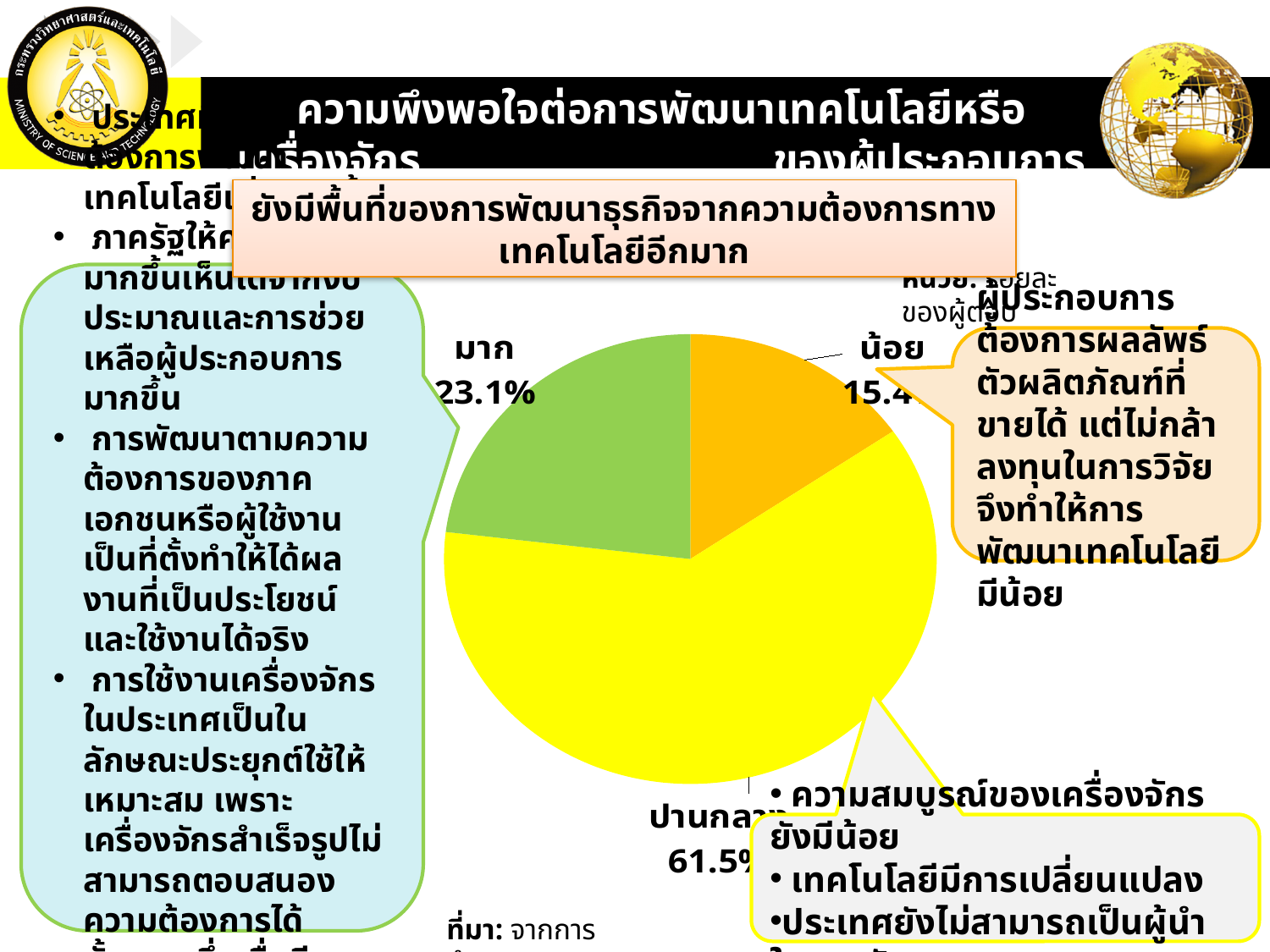
What colour is the ปานกลาง slice of the pie chart? yellow Is the share for ปานกลาง greater or less than 50%? greater How many slices does the pie chart have? 3 What percentage is shown for the ปานกลาง slice? 61.5% What type of chart is shown on the slide? pie chart Which category has the largest share of the pie? ปานกลาง Which slice is larger, มาก or น้อย? มาก What colour is the มาก slice of the pie chart? green What is the difference in percentage points between the ปานกลาง slice and the มาก slice? 38.4% Which category has the smallest share of the pie? น้อย What share of the pie does the มาก slice represent? 23.1% What percentage is shown for the มาก slice? 23.1%